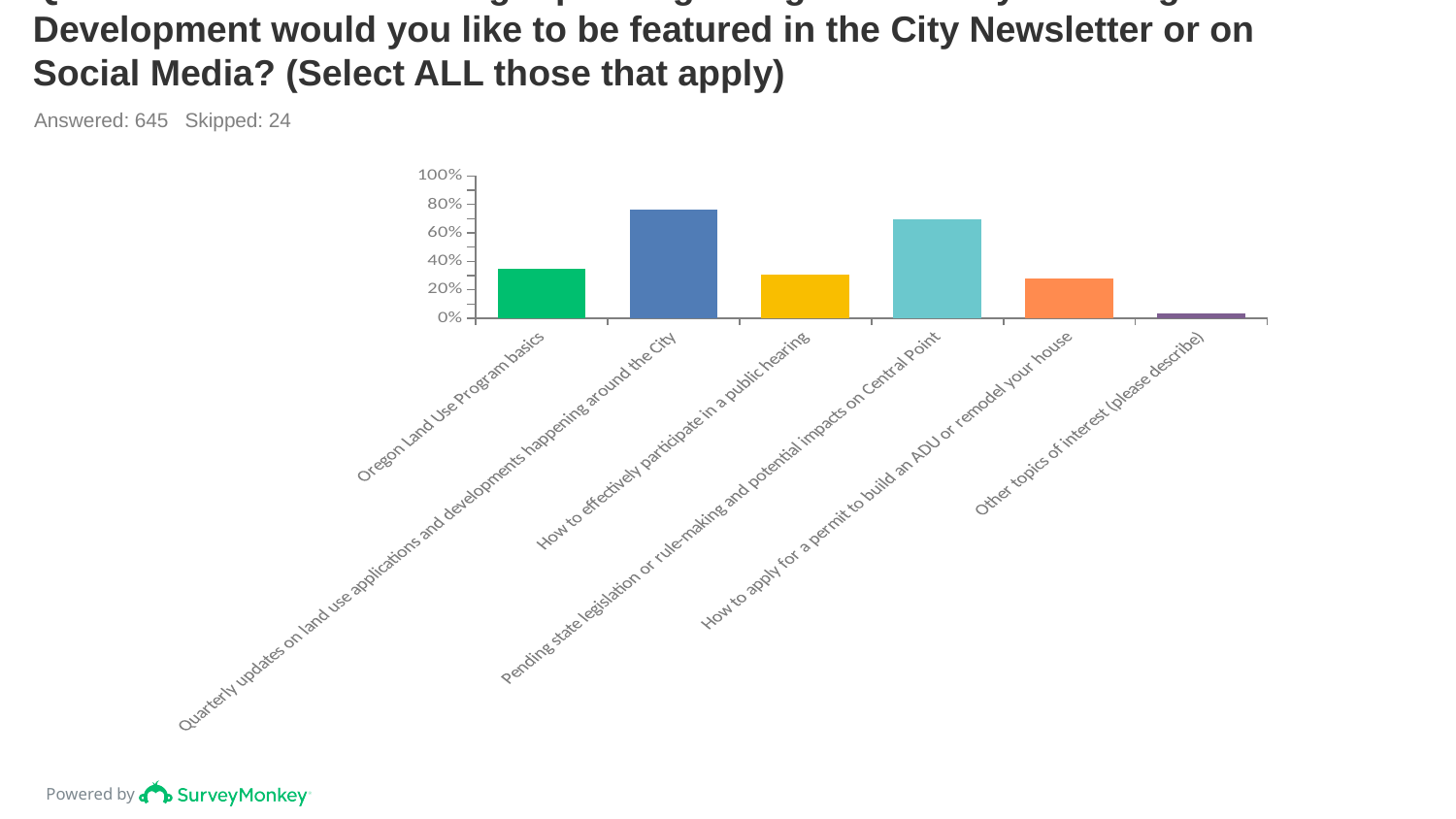
Is the value for 'Pending state legislation or rule-making and potential impacts on Central Point' greater or less than 80%? less Which category has the lowest value? Other topics of interest (please describe) How many categories (bars) are shown in the chart? 6 Which category has the highest value? Quarterly updates on land use applications and developments happening around the City Is the value for 'Oregon Land Use Program basics' greater or less than 40%? less Is the value for 'How to apply for a permit to build an ADU or remodel your house' greater or less than 20%? greater How many respondents answered this question according to the slide? 645 Which is larger: the value for 'Pending state legislation or rule-making and potential impacts on Central Point' or the value for 'How to apply for a permit to build an ADU or remodel your house'? Pending state legislation or rule-making and potential impacts on Central Point What kind of chart is shown on the slide? bar chart How many respondents skipped this question according to the slide? 24